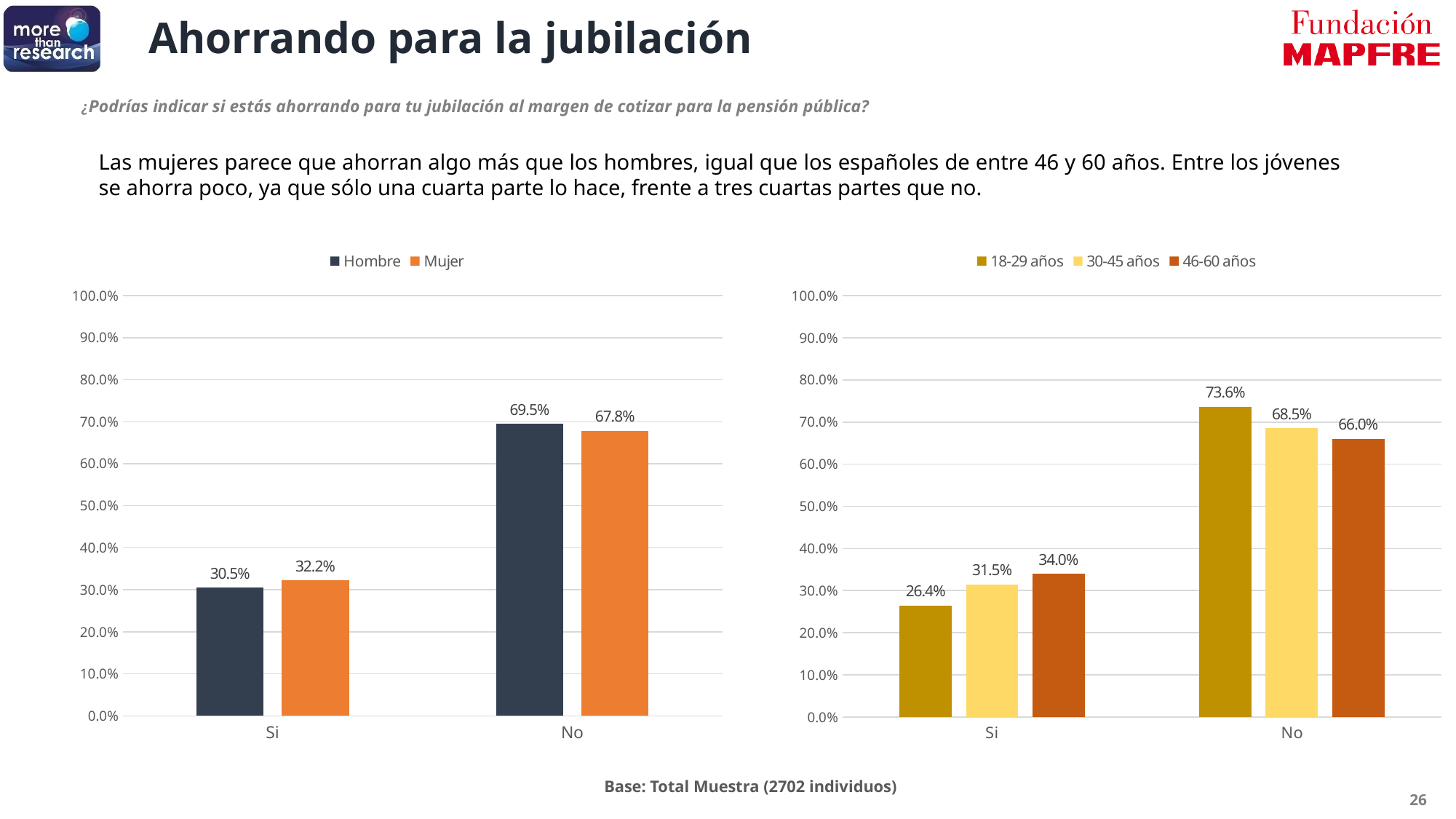
In the right chart (age groups), how many series does the legend list? 3 In the right chart (age groups), what is the value for 46-60 años in the Si category? 34.0% In the right chart (age groups), what is the value for 18-29 años in the No category? 73.6% In the right chart (age groups), what is the difference between 18-29 años and 46-60 años in the No category? 7.6% In the left chart (Hombre/Mujer), which series has the higher value in the Si category? Mujer In the left chart (Hombre/Mujer), what is the value for Mujer in the No category? 67.8% In the right chart (age groups), which age group has the lowest value in the Si category? 18-29 años In the right chart (age groups), which age group has the highest value in the No category? 18-29 años In the left chart (Hombre/Mujer), how many series does the legend list? 2 In the left chart (Hombre/Mujer), what is the value for Hombre in the Si category? 30.5% In the left chart (Hombre/Mujer), what is the difference between Hombre and Mujer in the No category? 1.7% What kind of chart is the left chart (Hombre/Mujer)? Bar chart